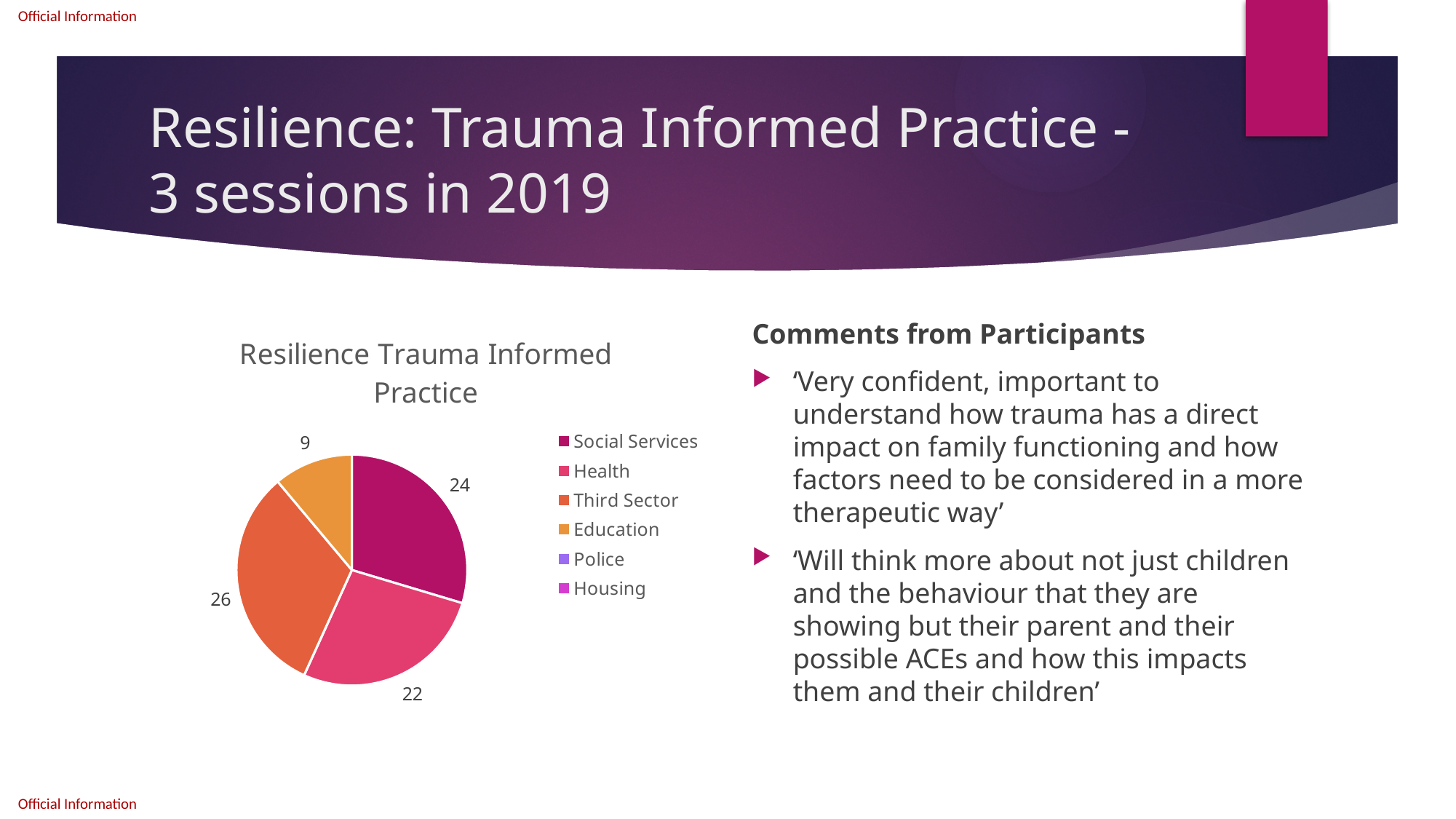
Which is larger, the value for Social Services or the value for Health? Social Services What is the value for Education in the pie chart? 9 What is the difference between the Third Sector value and the Education value? 17 What is the value for Third Sector in the pie chart? 26 What is the value for Health in the pie chart? 22 What type of chart is shown on the slide? pie chart Which labelled category has the smallest slice in the pie chart? Education What is the value for Social Services in the pie chart? 24 What colour is the Education slice in the pie chart? orange How many entries does the chart legend list? 6 Which category has the largest slice in the pie chart? Third Sector What is the title of the chart? Resilience Trauma Informed Practice